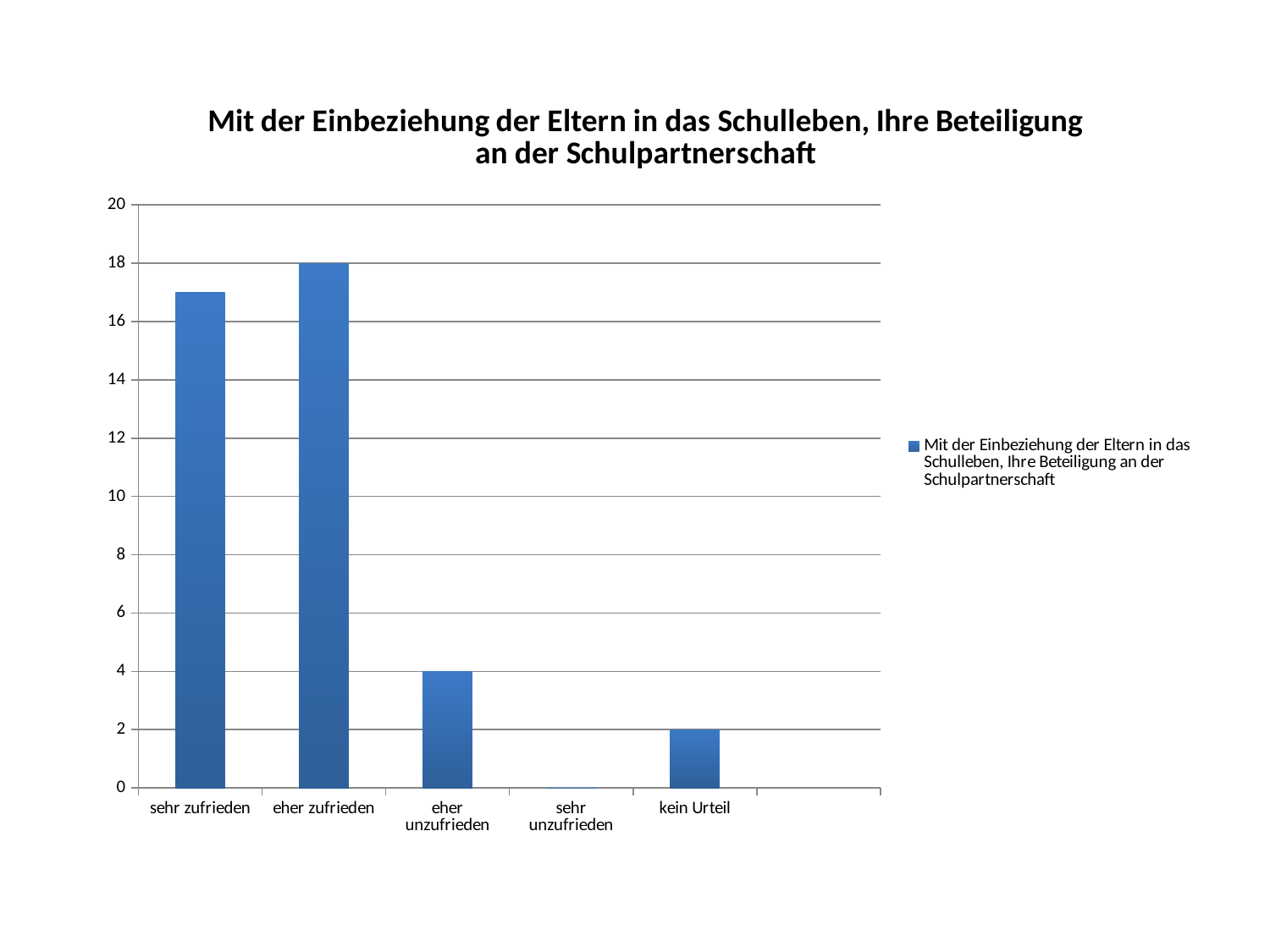
What is the value for "kein Urteil"? 2 What is the value for "eher unzufrieden"? 4 Which is larger, the value for "sehr zufrieden" or the value for "eher zufrieden"? eher zufrieden What is the value for "sehr unzufrieden"? 0 How many series does the legend list? 1 Is the value for "sehr zufrieden" greater or less than 16? greater Which category has the highest value? eher zufrieden What type of chart is shown on the slide? bar chart What is the value for "eher zufrieden"? 18 What is the difference between the values for "eher zufrieden" and "eher unzufrieden"? 14 How many category labels are shown on the x axis? 5 Which category has the lowest value? sehr unzufrieden